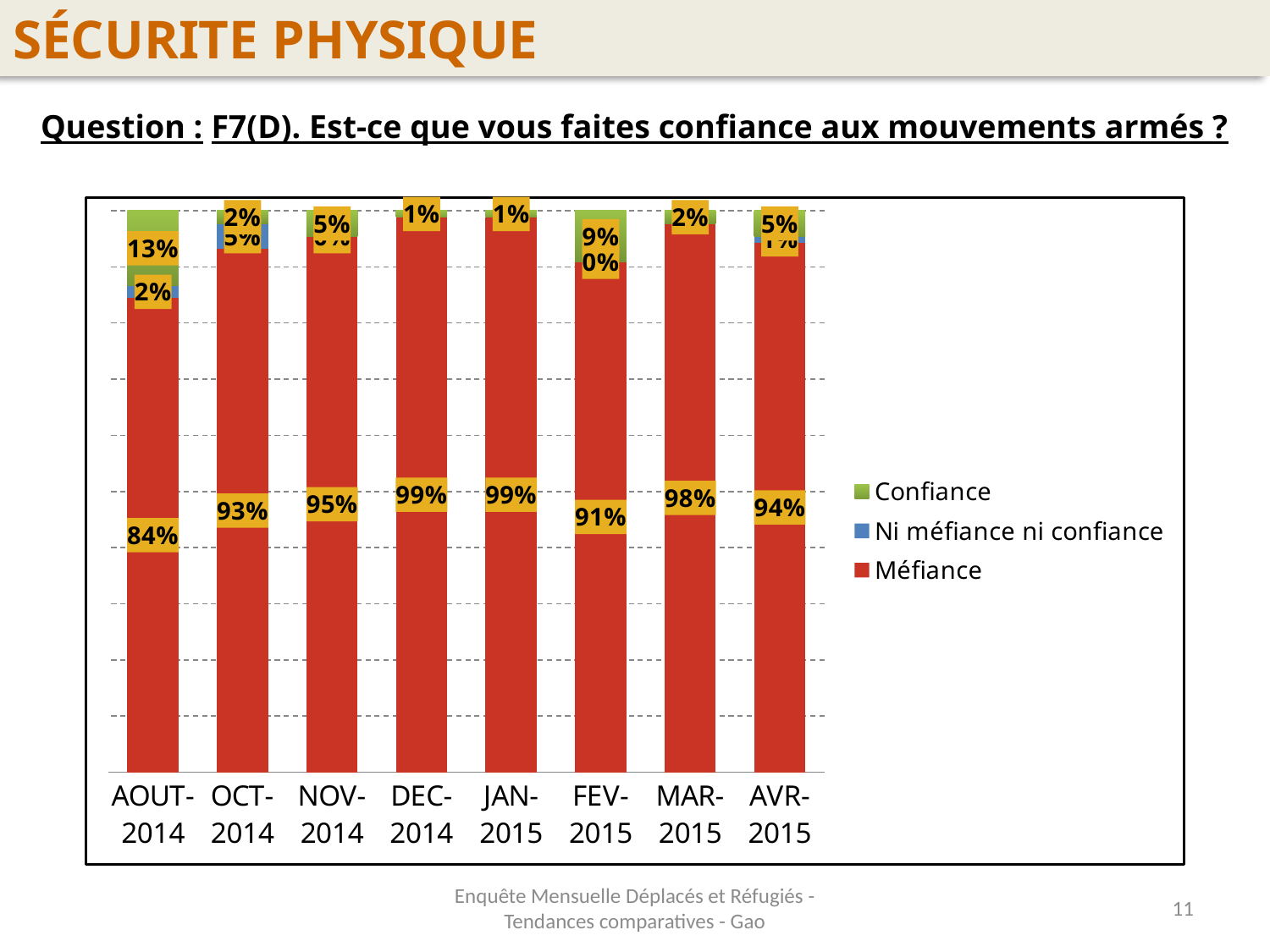
Which is larger, the Méfiance value for OCT-2014 or for NOV-2014? NOV-2014 What is the Méfiance value for AOUT-2014? 84% What kind of chart is shown on the slide? stacked bar chart What is the difference between the Méfiance values for MAR-2015 and AVR-2015? 4% How many series does the legend list? 3 How many months are shown on the x axis? 8 Which series is shown in red? Méfiance What is the Méfiance value for FEV-2015? 91% What is the Ni méfiance ni confiance value for AOUT-2014? 2% Which month has the lowest Méfiance value? AOUT-2014 What is the Confiance value for FEV-2015? 9% What is the Confiance value for AOUT-2014? 13%